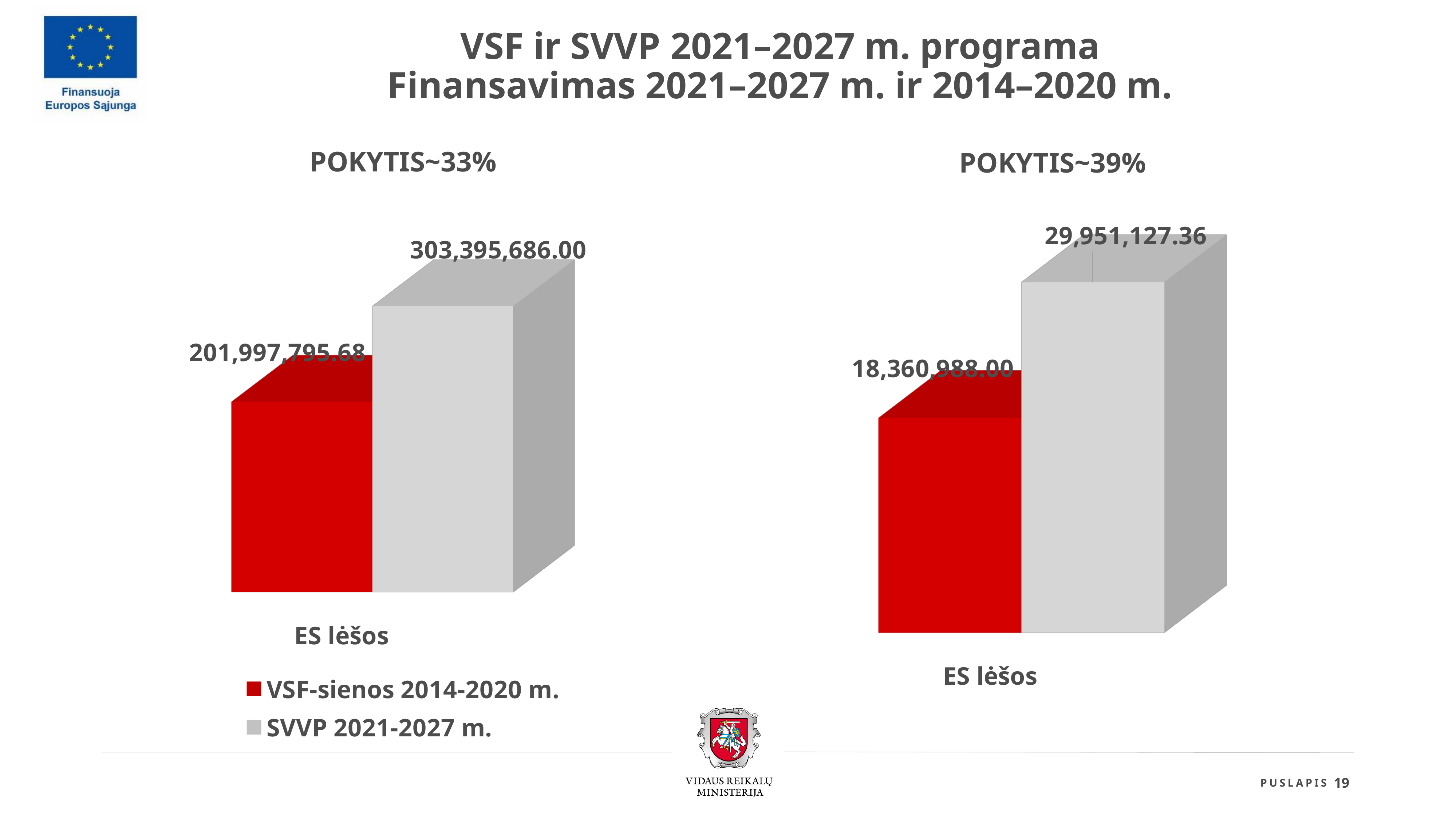
What is the category label shown on the x axis of the left chart (POKYTIS~33%)? ES lėšos In the left chart (POKYTIS~33%), what is the value for SVVP 2021-2027 m.? 303,395,686.00 In the right chart (POKYTIS~39%), what is the value of the red bar? 18,360,988.00 In the left chart (POKYTIS~33%), is the value for VSF-sienos 2014-2020 m. larger or smaller than the value for SVVP 2021-2027 m.? smaller In the left chart (POKYTIS~33%), what is the difference between the SVVP 2021-2027 m. value and the VSF-sienos 2014-2020 m. value? 101,397,890.32 In the right chart (POKYTIS~39%), what is the value of the grey bar? 29,951,127.36 In the left chart (POKYTIS~33%), what is the value for VSF-sienos 2014-2020 m.? 201,997,795.68 What type of chart is the right chart (POKYTIS~39%)? bar chart In the left chart (POKYTIS~33%), which series has the higher value? SVVP 2021-2027 m. How many series does the legend of the left chart (POKYTIS~33%) list? 2 In the right chart (POKYTIS~39%), which bar is lower, the red bar or the grey bar? the red bar In the right chart (POKYTIS~39%), what is the difference between the grey bar value and the red bar value? 11,590,139.36